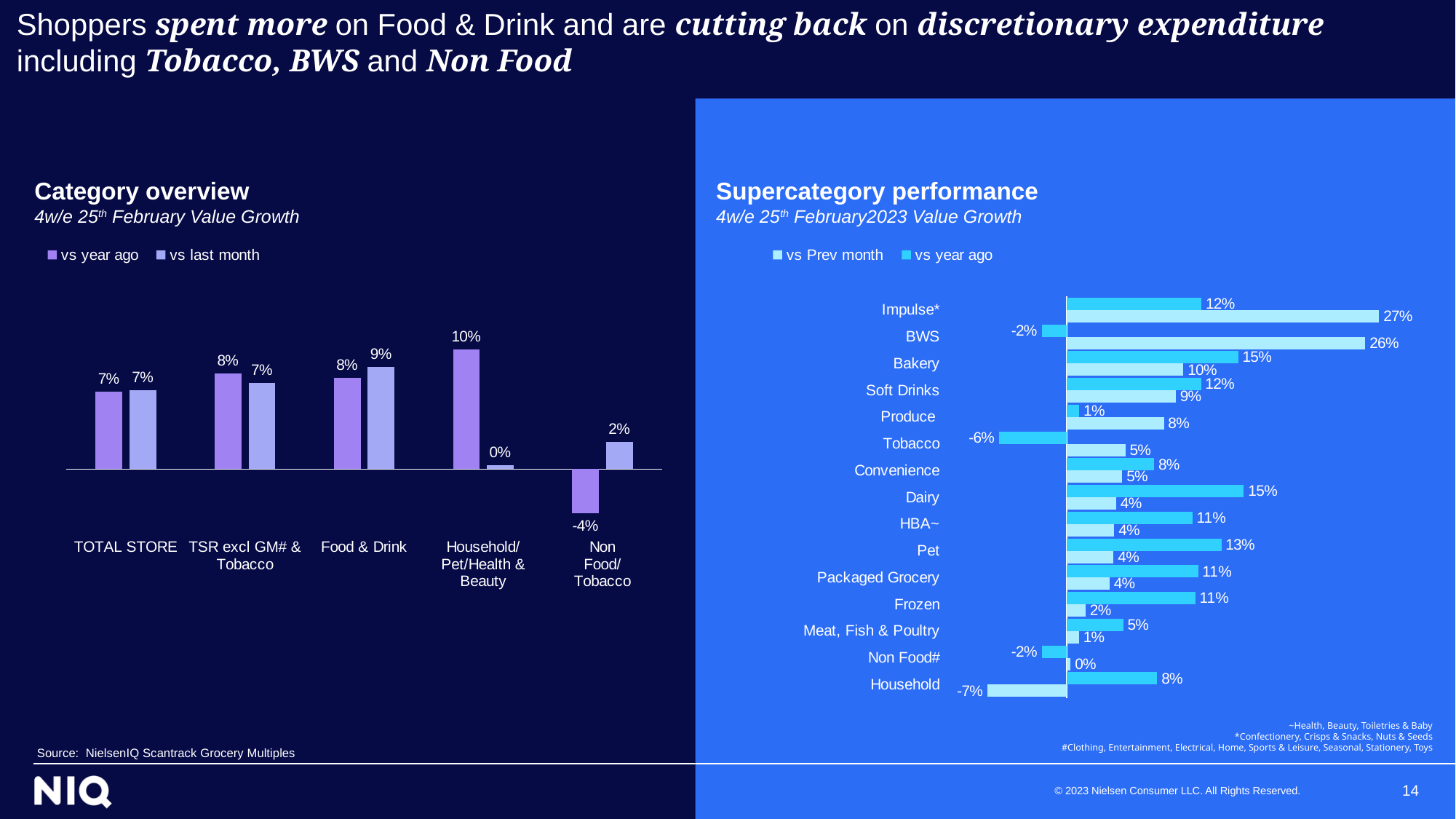
In the Category overview chart, which category has the lowest vs year ago value? Non Food/Tobacco In the Category overview chart, which is larger: the vs year ago value for Food & Drink or for TOTAL STORE? Food & Drink In the Supercategory performance chart, which supercategory has the lowest vs Prev month value? Household In the Category overview chart, what is the vs year ago value for Food & Drink? 8% What type of chart is the Category overview chart? Bar chart How many categories are shown in the Category overview chart? 5 In the Category overview chart, what is the difference between the vs last month and vs year ago values for Non Food/Tobacco? 6 percentage points How many series does the legend of the Supercategory performance chart list? 2 How many supercategories are shown in the Supercategory performance chart? 15 In the Category overview chart, which category has the highest vs year ago value? Household/Pet/Health & Beauty In the Category overview chart, what is the vs last month value for Household/Pet/Health & Beauty? 0% In the Supercategory performance chart, what is the vs year ago value for Tobacco? -6%